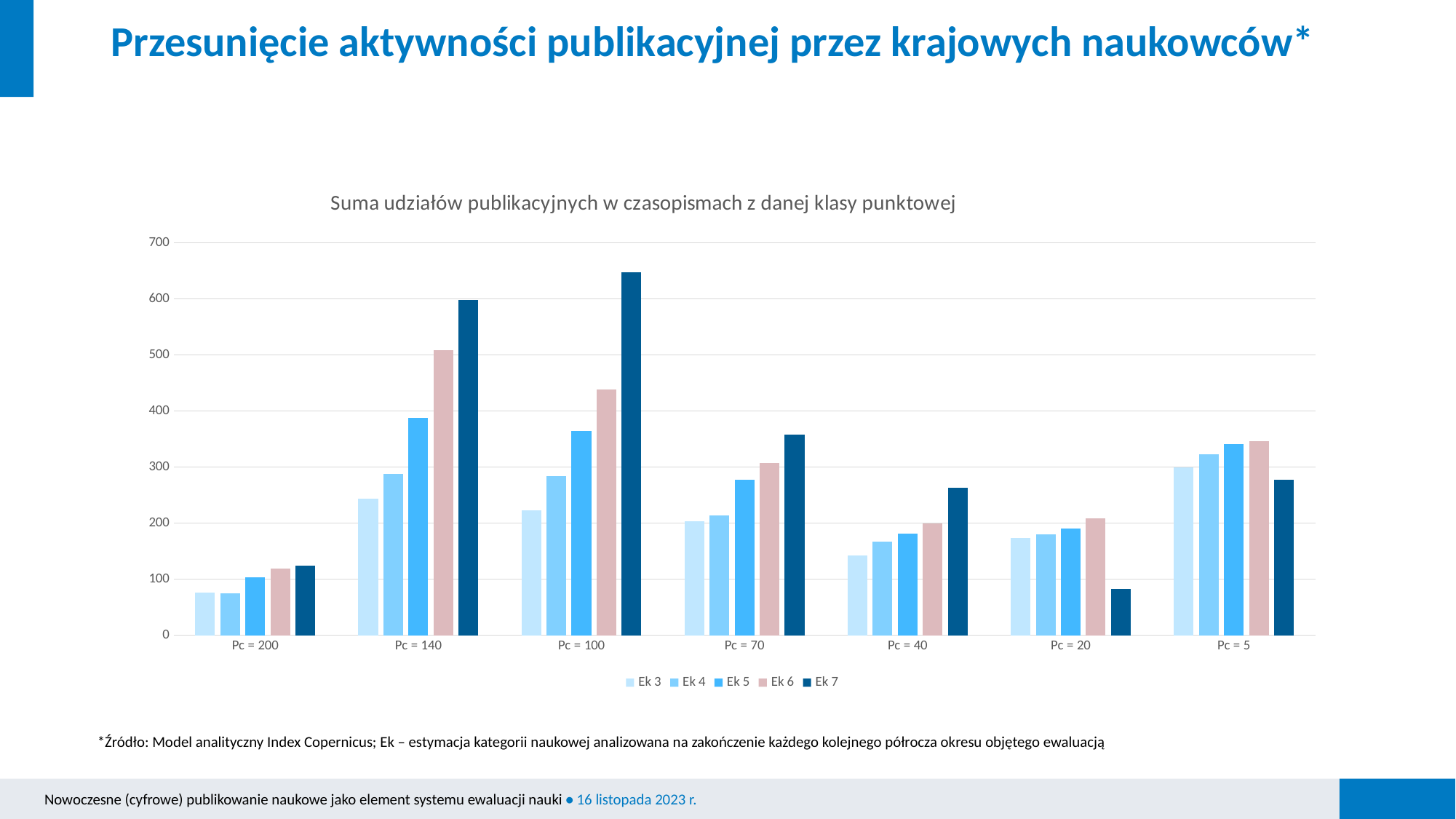
What is the title of the chart? Suma udziałów publikacyjnych w czasopismach z danej klasy punktowej Within the Pc = 140 group, do the values rise or fall from Ek 3 to Ek 7? rise How many series does the legend list? 5 What kind of chart is shown on the slide? bar chart For Pc = 20, which series has the larger value, Ek 6 or Ek 7? Ek 6 Is the Ek 7 value for Pc = 140 greater or less than 500? greater How many Pc categories are shown on the x axis? 7 Is the Ek 3 value for Pc = 5 greater or less than 200? greater In which Pc category is the Ek 7 value lowest? Pc = 20 For Pc = 100, which series has the larger value, Ek 6 or Ek 7? Ek 7 In which Pc category does the Ek 7 series reach its highest value? Pc = 100 Is the Ek 7 value for Pc = 20 greater or less than 100? less